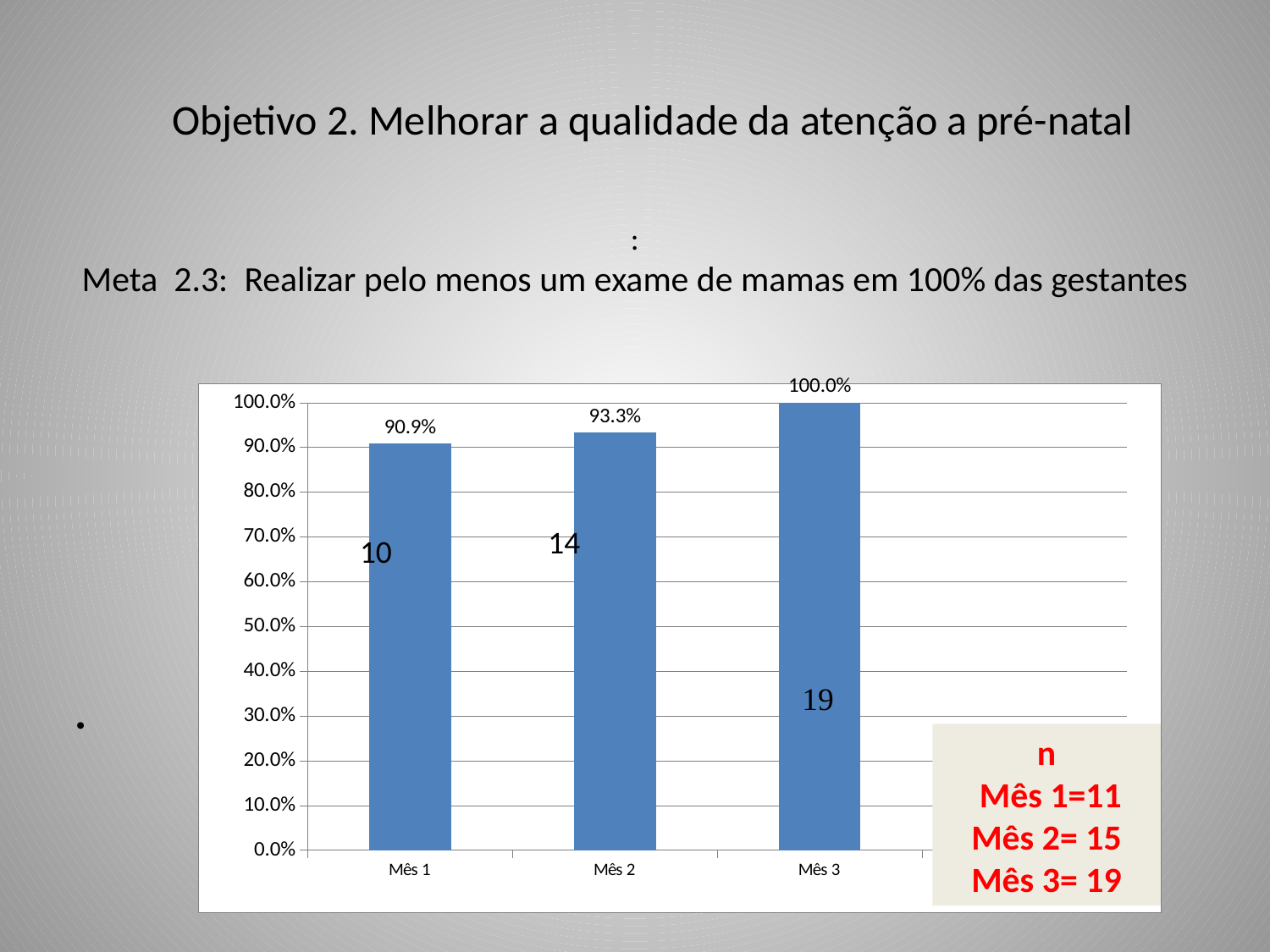
According to the text box on the slide, what is n for Mês 2? 15 What is the difference between the values for Mês 3 and Mês 1? 9.1% Which is larger, the value for Mês 2 or the value for Mês 1? Mês 2 What is the value for Mês 1? 90.9% Which month has the highest value? Mês 3 Which month has the lowest value? Mês 1 What is the value for Mês 2? 93.3% What number is printed inside the bar for Mês 2? 14 What is the value for Mês 3? 100.0% Do the values rise or fall from Mês 1 to Mês 3? Rise What kind of chart is shown on the slide? Bar chart How many categories are shown on the x axis? 3